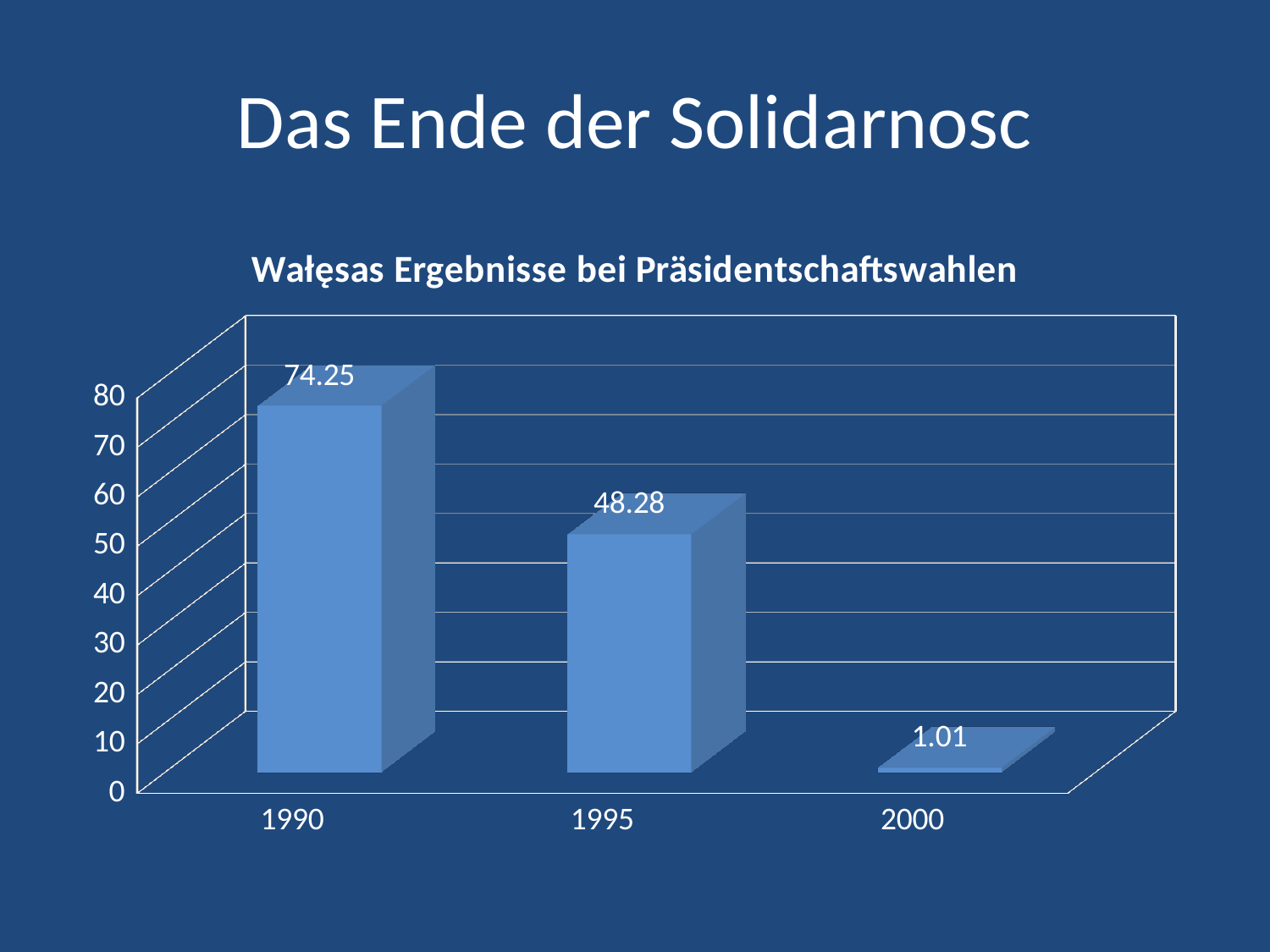
What kind of chart is shown? bar chart How many years are shown on the x axis? 3 What is the difference between the values for 1995 and 2000? 47.27 What is the value for 2000? 1.01 Do the values rise or fall from 1990 to 2000? fall Is the value for 1995 greater or less than 40? greater Which is larger, the value for 1995 or the value for 2000? 1995 Which year has the lowest value? 2000 What is the value for 1995? 48.28 What is the difference between the values for 1990 and 1995? 25.97 Which year has the highest value? 1990 What is the value for 1990? 74.25